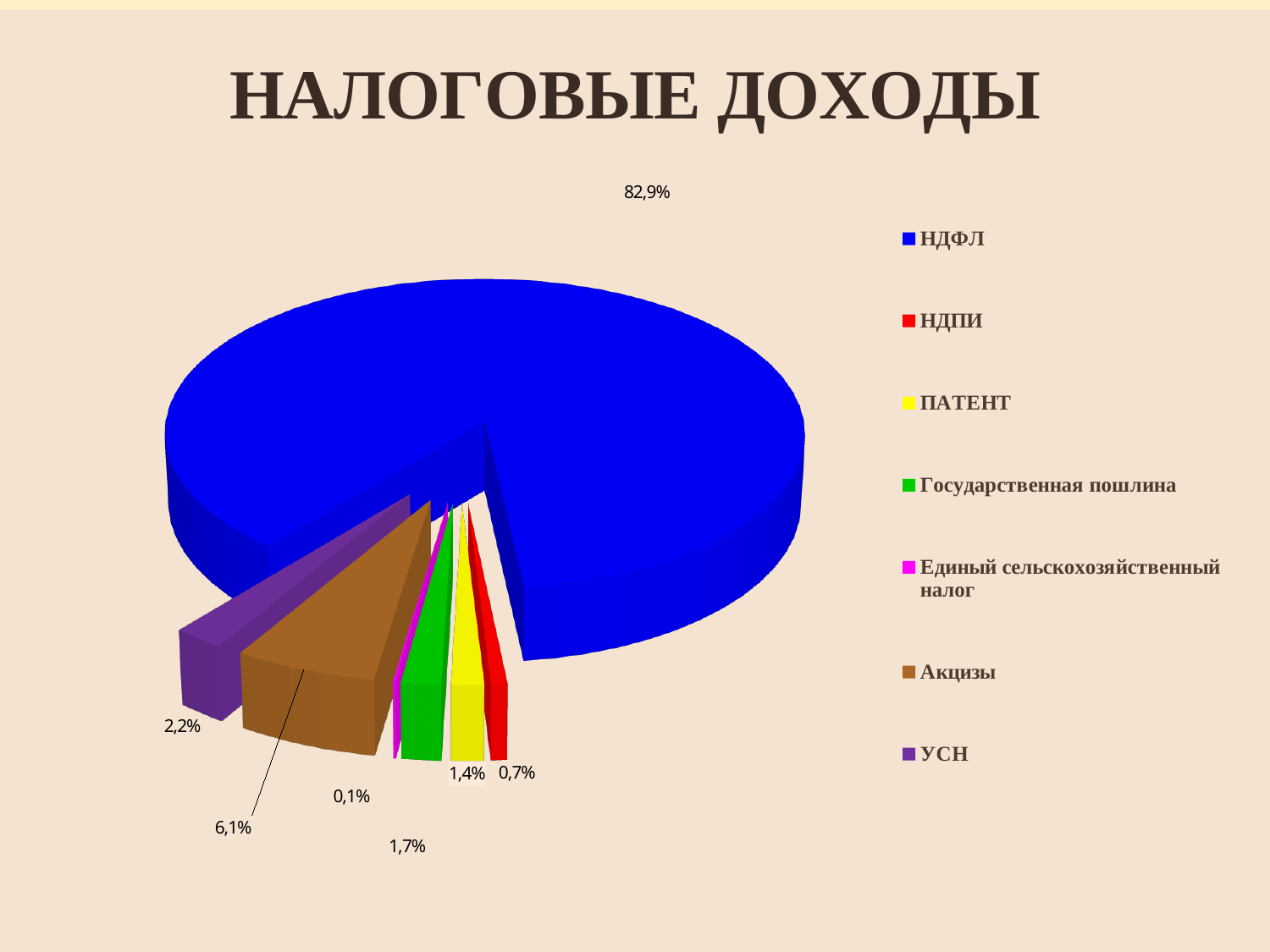
How many categories does the legend list? 7 Which is larger, the share for Акцизы or the share for УСН? Акцизы What share of the pie does УСН have? 2,2% What share of the pie does Акцизы have? 6,1% Which category has the largest slice of the pie? НДФЛ Which colour represents НДФЛ in the chart? blue What is the difference between the share for НДФЛ and the share for Акцизы? 76,8% What share of the pie does НДФЛ have? 82,9% What share of the pie does НДПИ have? 0,7% What type of chart is shown on the slide? pie chart What share of the pie does ПАТЕНТ have? 1,4% What is the title of the chart? НАЛОГОВЫЕ ДОХОДЫ